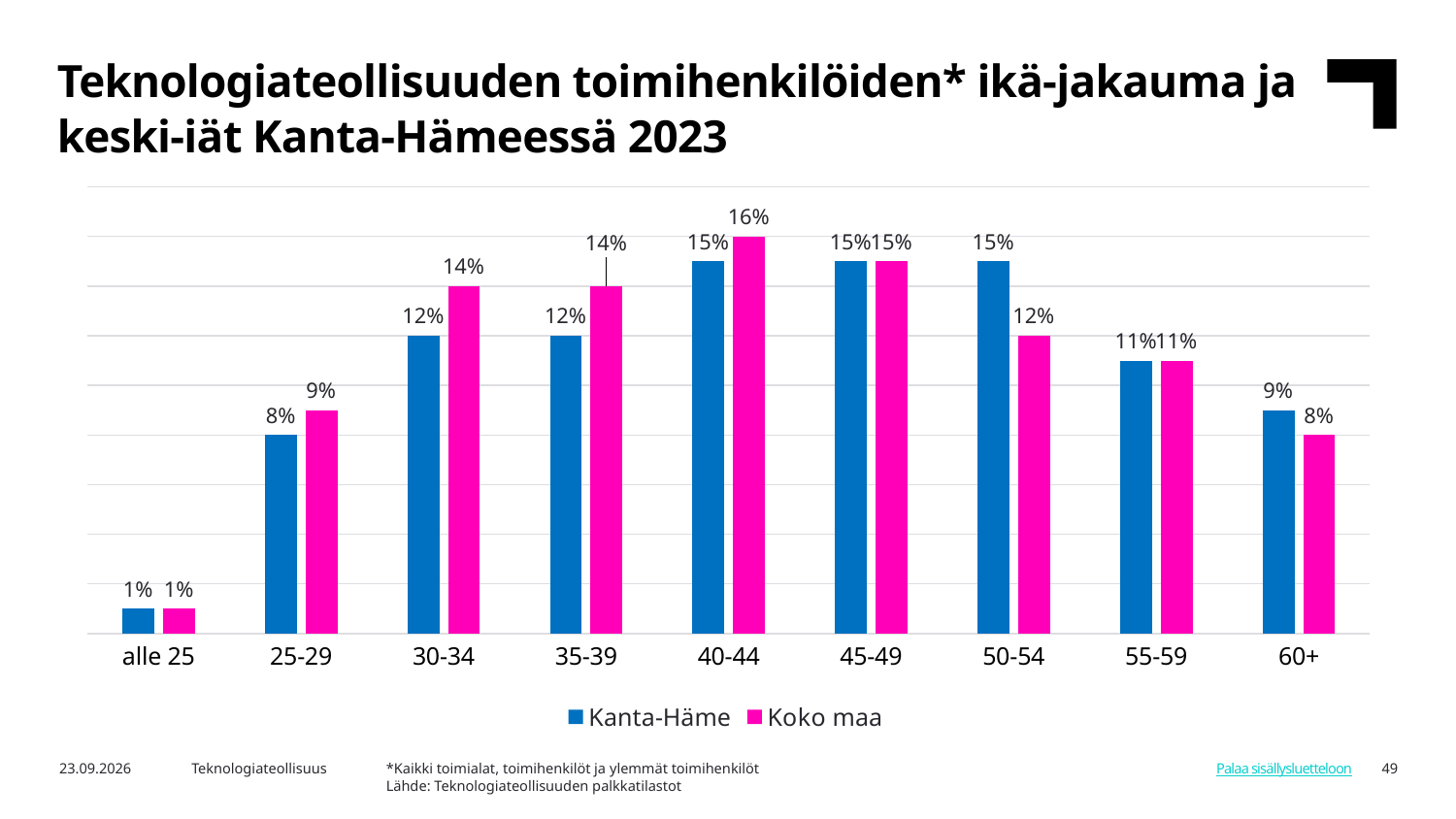
Which age group has the highest value for Koko maa? 40-44 What kind of chart is shown on the slide? Bar chart In the 50-54 age group, which series has the larger value, Kanta-Häme or Koko maa? Kanta-Häme Which colour represents the Koko maa series? Magenta (pink) What is the difference between Koko maa and Kanta-Häme in the 35-39 age group? 2 percentage points What is the value for Koko maa in the 40-44 age group? 16% What is the value for Koko maa in the 50-54 age group? 12% What is the value for Kanta-Häme in the 30-34 age group? 12% What is the value for Kanta-Häme in the 60+ age group? 9% How many series does the legend list? 2 How many age groups are shown on the x axis? 9 Which age group has the lowest value for Kanta-Häme? alle 25